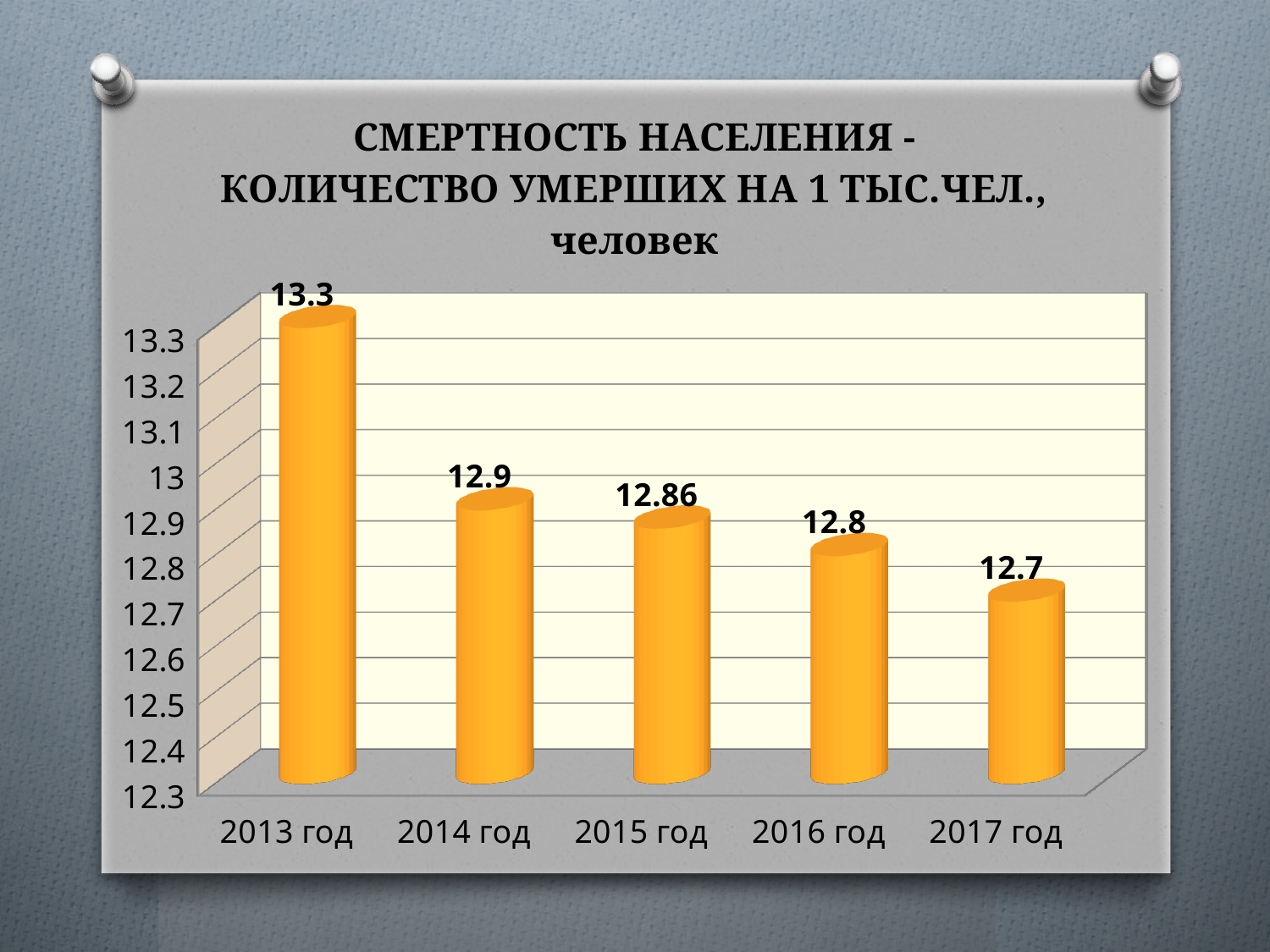
What is the difference between the values for 2014 год and 2016 год? 0.1 Which is larger, the value for 2014 год or the value for 2016 год? 2014 год What is the value for 2015 год? 12.86 What is the value for 2013 год? 13.3 Which year has the lowest value? 2017 год Do the values rise or fall from 2013 год to 2017 год? fall What is the difference between the values for 2013 год and 2017 год? 0.6 Is the value for 2013 год greater or less than 13? greater What kind of chart is shown on the slide? bar chart Which year has the highest value? 2013 год What is the value for 2017 год? 12.7 How many years are shown on the chart? 5